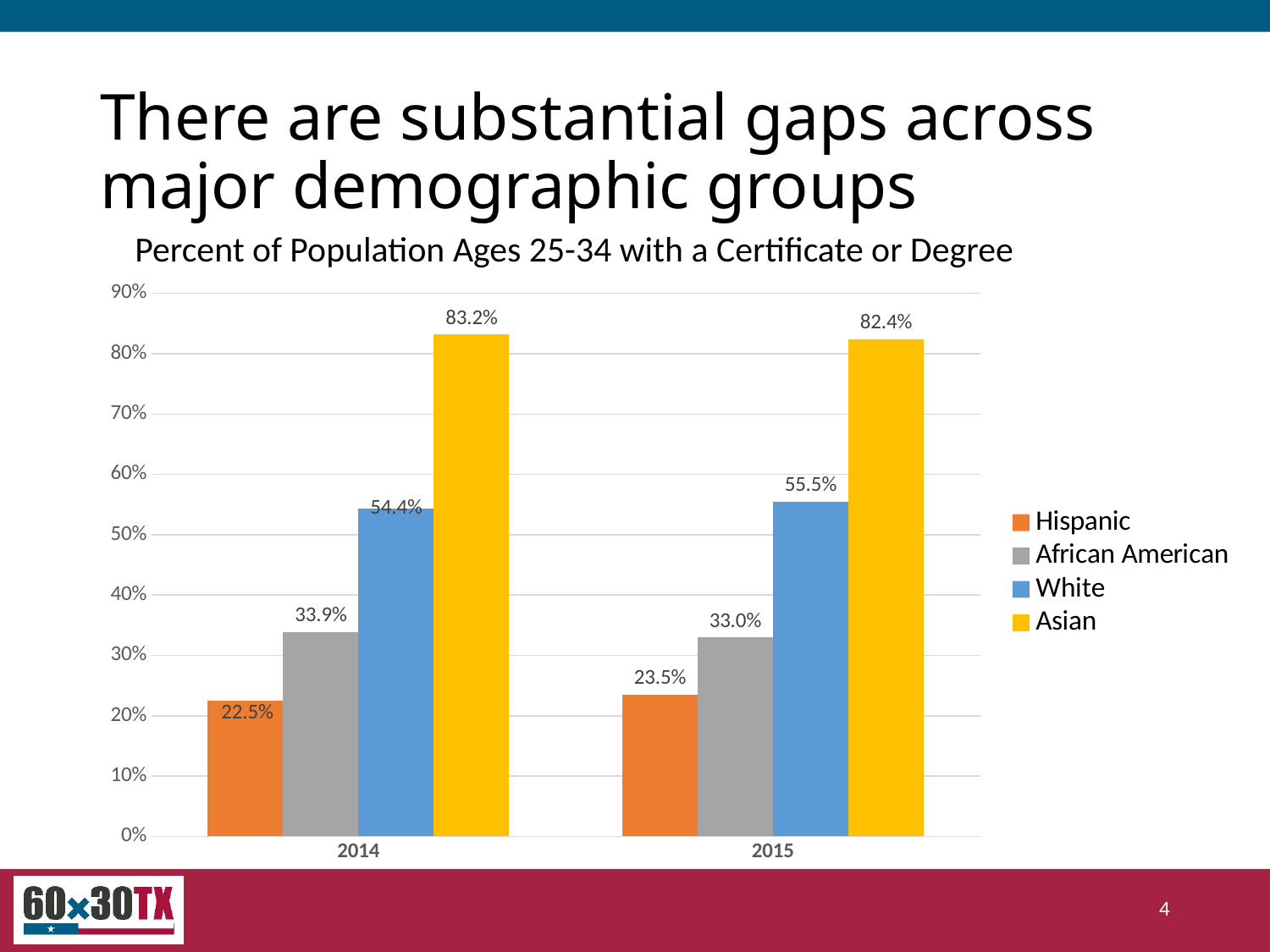
What is the value for Asian in 2014? 83.2% How many series does the legend list? 4 Which group has the highest value in 2015? Asian What kind of chart is shown? Bar chart Which group has the lowest value in 2014? Hispanic What is the value for Hispanic in 2015? 23.5% Which is larger, the White value in 2014 or the White value in 2015? 2015 What is the difference between the Asian and Hispanic values in 2014? 60.7% What is the value for African American in 2015? 33.0% What is the value for White in 2014? 54.4% How many year categories are shown on the x axis? 2 What is the title of the chart? Percent of Population Ages 25-34 with a Certificate or Degree